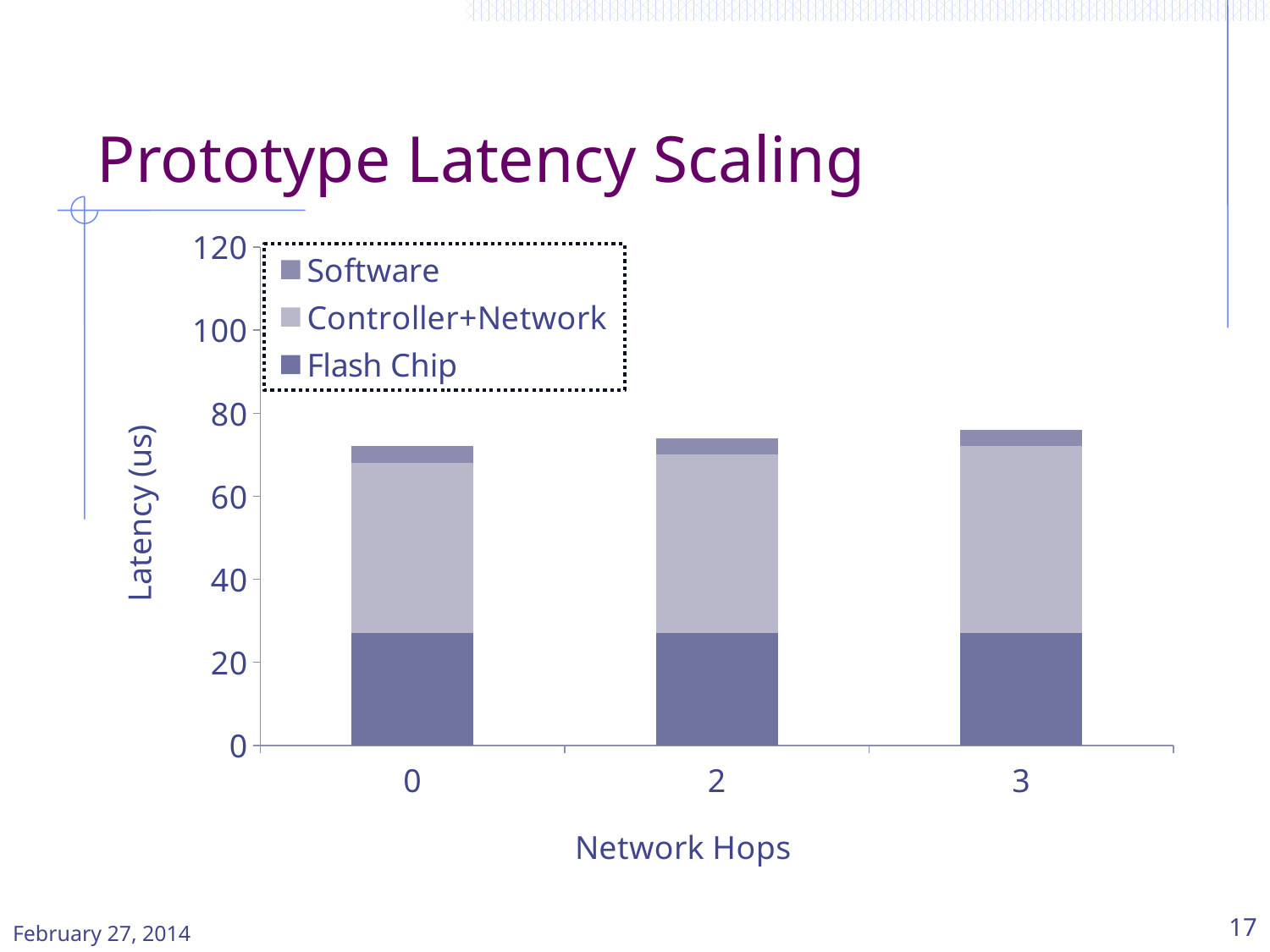
Which series forms the largest segment of each stacked bar? Controller+Network What kind of chart is shown on the slide? stacked bar chart Does the total latency rise or fall as the number of network hops increases along the x axis? rise How many network-hop categories are plotted on the x axis? 3 Is the Flash Chip latency for 2 network hops greater or less than 40? less Is the total latency for 2 network hops greater or less than 100? less What is the label of the y axis? Latency (us) What is the title of the chart? Prototype Latency Scaling Is the Flash Chip latency for 0 network hops greater or less than 20? greater How many series does the legend list? 3